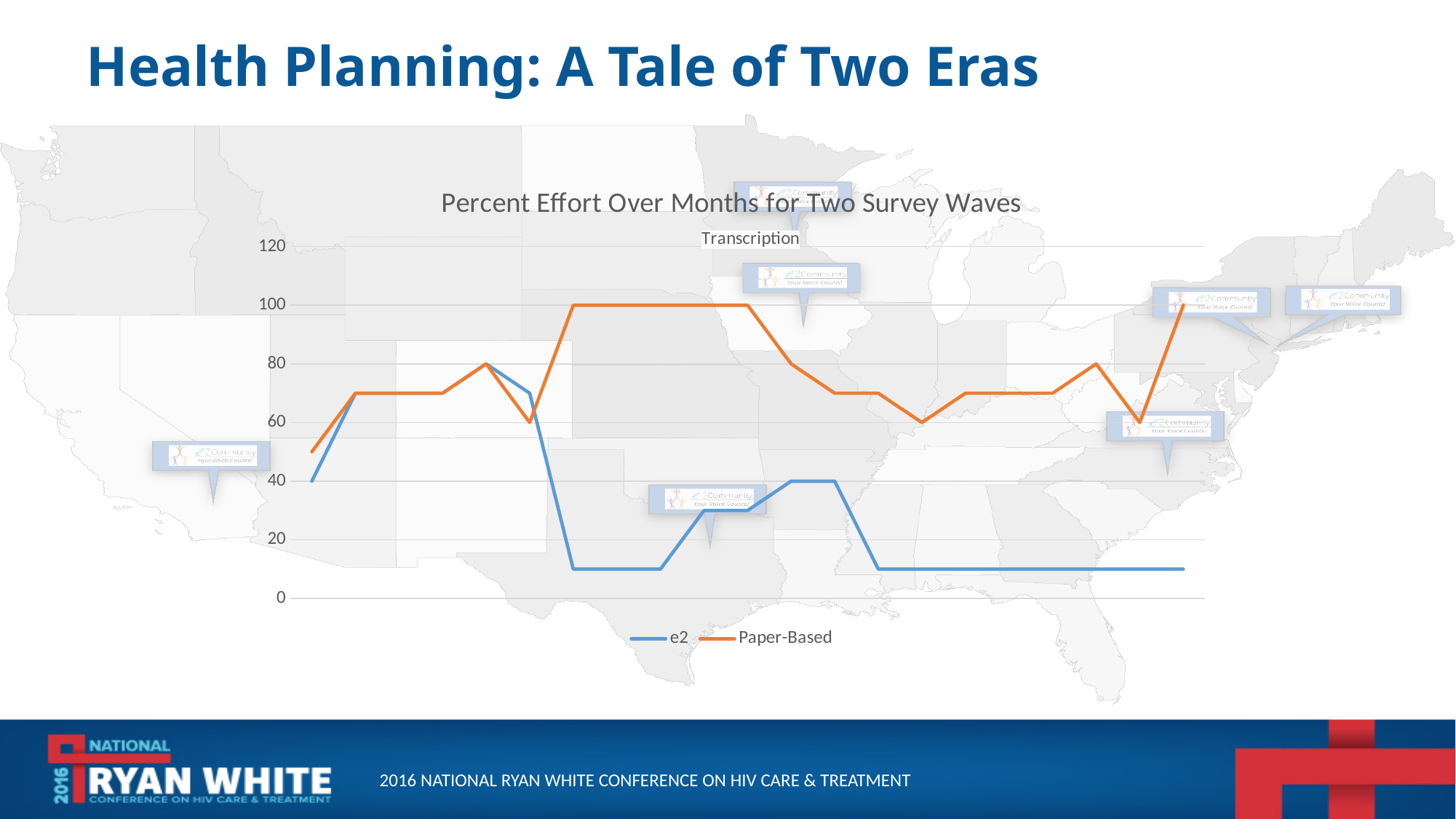
Does the e2 line end higher or lower than it starts? lower Is the final value of the e2 line greater or less than 20? less Is the final value of the Paper-Based line greater or less than 80? greater What kind of chart is shown on the slide? line chart Which series reaches the higher peak value, e2 or Paper-Based? Paper-Based How many series does the chart's legend list? 2 What is the highest value reached by the e2 line? 80 Does the Paper-Based line end higher or lower than it starts? higher What is the highest value reached by the Paper-Based line? 100 What is the title of the chart? Percent Effort Over Months for Two Survey Waves What are the two series named in the chart's legend? e2 and Paper-Based At the right end of the x axis, which series has the higher value, e2 or Paper-Based? Paper-Based